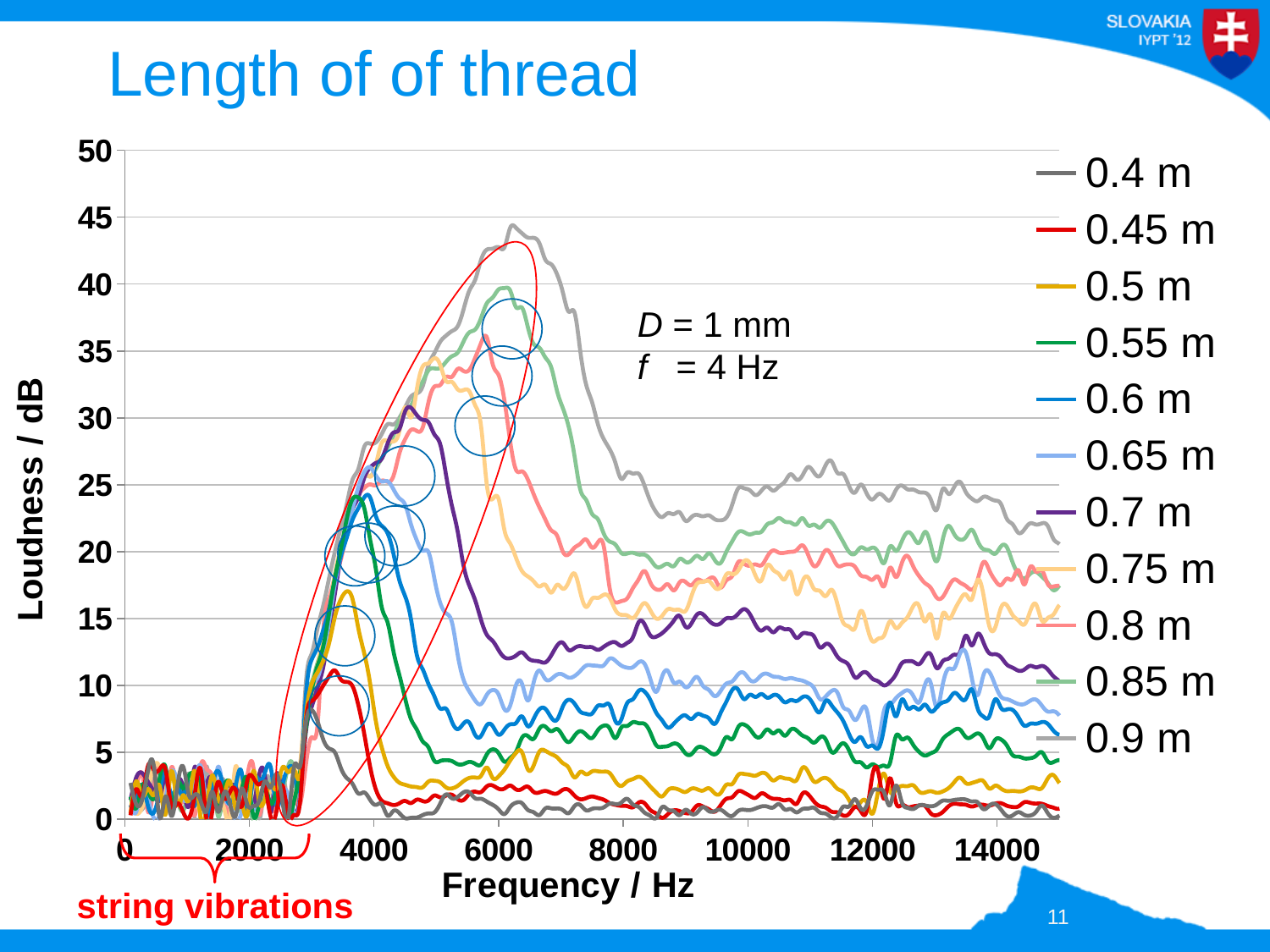
How many series does the legend list? 11 Which thread length series reaches the highest peak loudness? 0.9 m What is the label of the x axis? Frequency / Hz Is the loudness of the 0.85 m series at 10000 Hz greater or less than 15 dB? greater What is the title of the slide? Length of of thread Does the loudness of the 0.9 m series rise or fall between 6000 Hz and 8000 Hz? fall What kind of chart is shown on the slide? line chart Does the loudness of the 0.85 m series rise or fall between 4000 Hz and 6000 Hz? rise Is the peak loudness of the 0.9 m series greater or less than 40 dB? greater Is the peak loudness of the 0.5 m series greater or less than 20 dB? less Which series has the higher peak loudness, 0.9 m or 0.7 m? 0.9 m